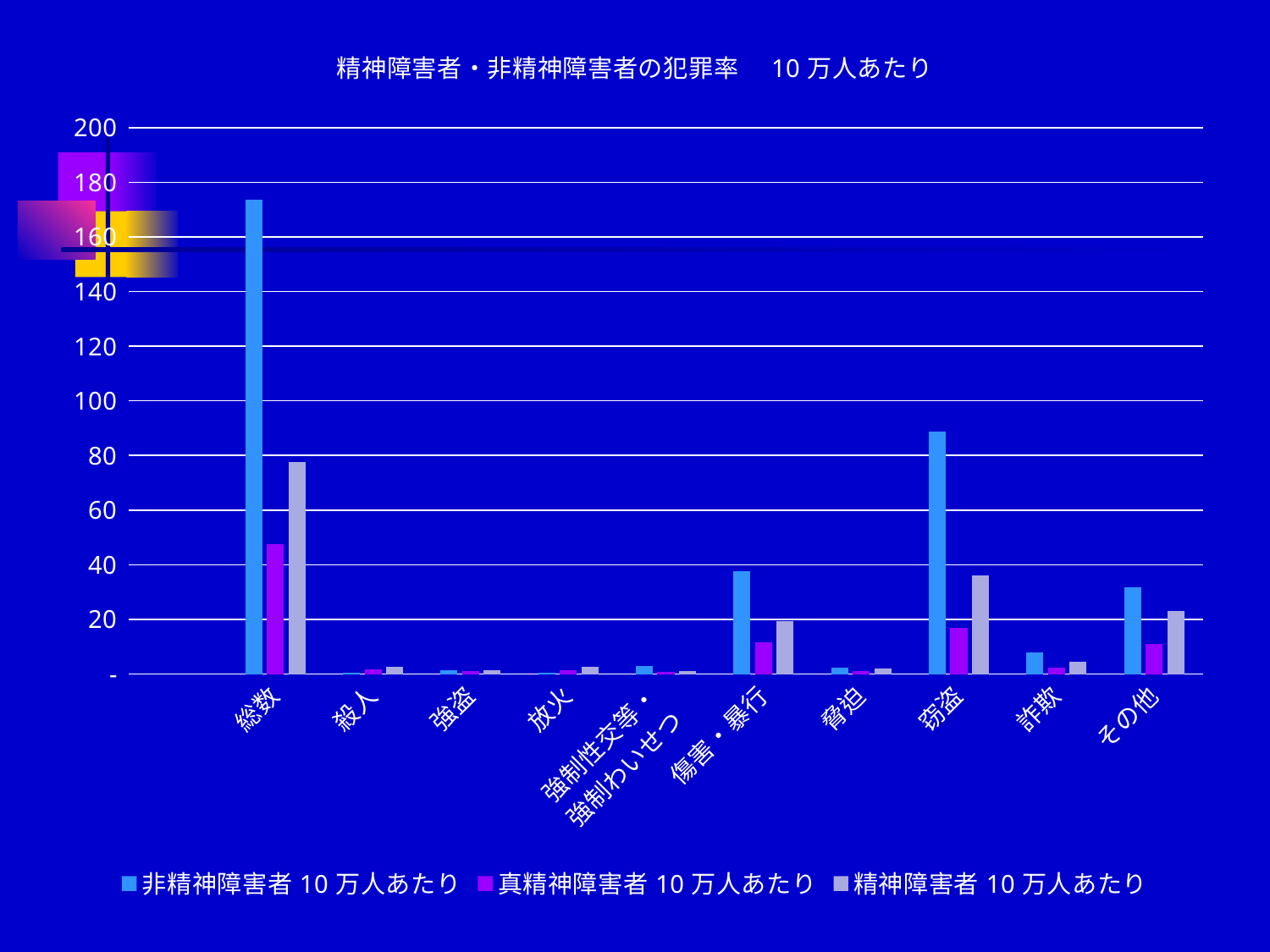
In 総数, which is larger: 真精神障害者 10 万人あたり or 精神障害者 10 万人あたり? 精神障害者 10 万人あたり Is the value for 非精神障害者 10 万人あたり in 窃盗 greater or less than 80? greater Which category has the highest value for 精神障害者 10 万人あたり? 総数 Is the value for 精神障害者 10 万人あたり in 総数 greater or less than 60? greater Which category has the highest value for 非精神障害者 10 万人あたり? 総数 What is the title of the chart? 精神障害者・非精神障害者の犯罪率 10 万人あたり Is the value for 非精神障害者 10 万人あたり in 総数 greater or less than 160? greater How many categories are shown along the x axis? 10 What kind of chart is shown on the slide? bar chart For 非精神障害者 10 万人あたり, which is larger: 窃盗 or 傷害・暴行? 窃盗 How many series does the legend list? 3